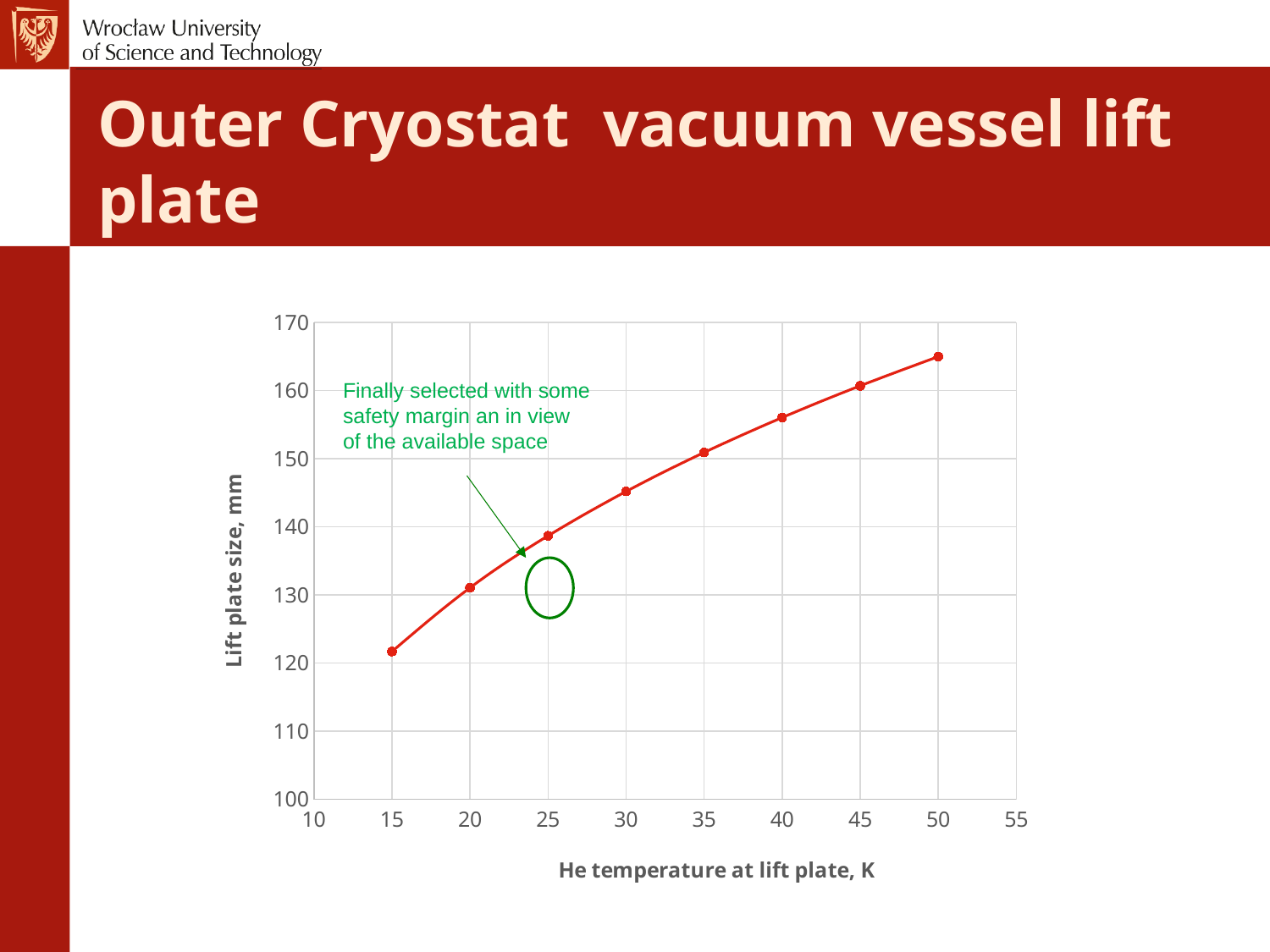
Does the lift plate size rise or fall as the He temperature increases along the x axis? rise Is the lift plate size at 50 K greater or less than 160? greater Is the lift plate size at 30 K greater or less than 140? greater What is the label of the y axis? Lift plate size, mm At which He temperature is the lift plate size highest? 50 Is the lift plate size at 15 K greater or less than 130? less What kind of chart is shown on the slide? line chart What is the label of the x axis? He temperature at lift plate, K At which He temperature is the lift plate size lowest? 15 How many data points are plotted on the line? 8 Which has the larger lift plate size, 20 K or 40 K? 40 K